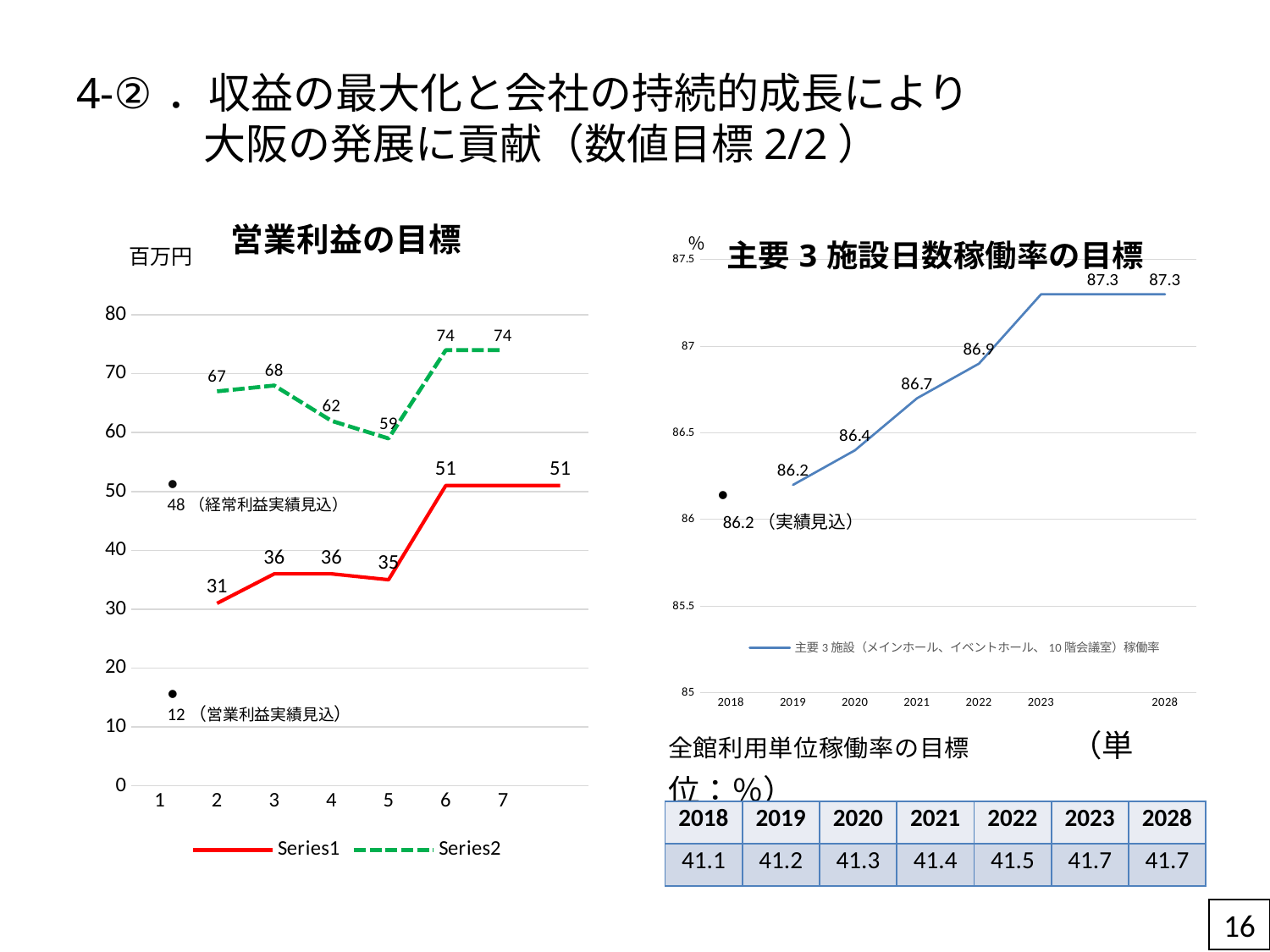
In the 営業利益の目標 chart, how many series does the legend list? 2 In the 営業利益の目標 chart, at which x value is Series1 lowest? 2 In the 営業利益の目標 chart, which is larger at x = 4: Series1 or Series2? Series2 In the 営業利益の目標 chart, what unit is shown above the y axis? 百万円 In the 主要3施設日数稼働率の目標 chart, what is the value for 2021? 86.7 In the 主要3施設日数稼働率の目標 chart, what is the value for 2028? 87.3 In the 営業利益の目標 chart, what is the value of Series2 at x = 3? 68 In the 営業利益の目標 chart, what is the difference between Series2 and Series1 at x = 6? 23 What type of chart is the 営業利益の目標 chart? Line chart In the 主要3施設日数稼働率の目標 chart, what is the difference between the 2023 value and the 2019 value? 1.1 In the 主要3施設日数稼働率の目標 chart, do the values rise or fall from 2019 to 2023? Rise In the 営業利益の目標 chart, what is the value of Series1 at x = 5? 35